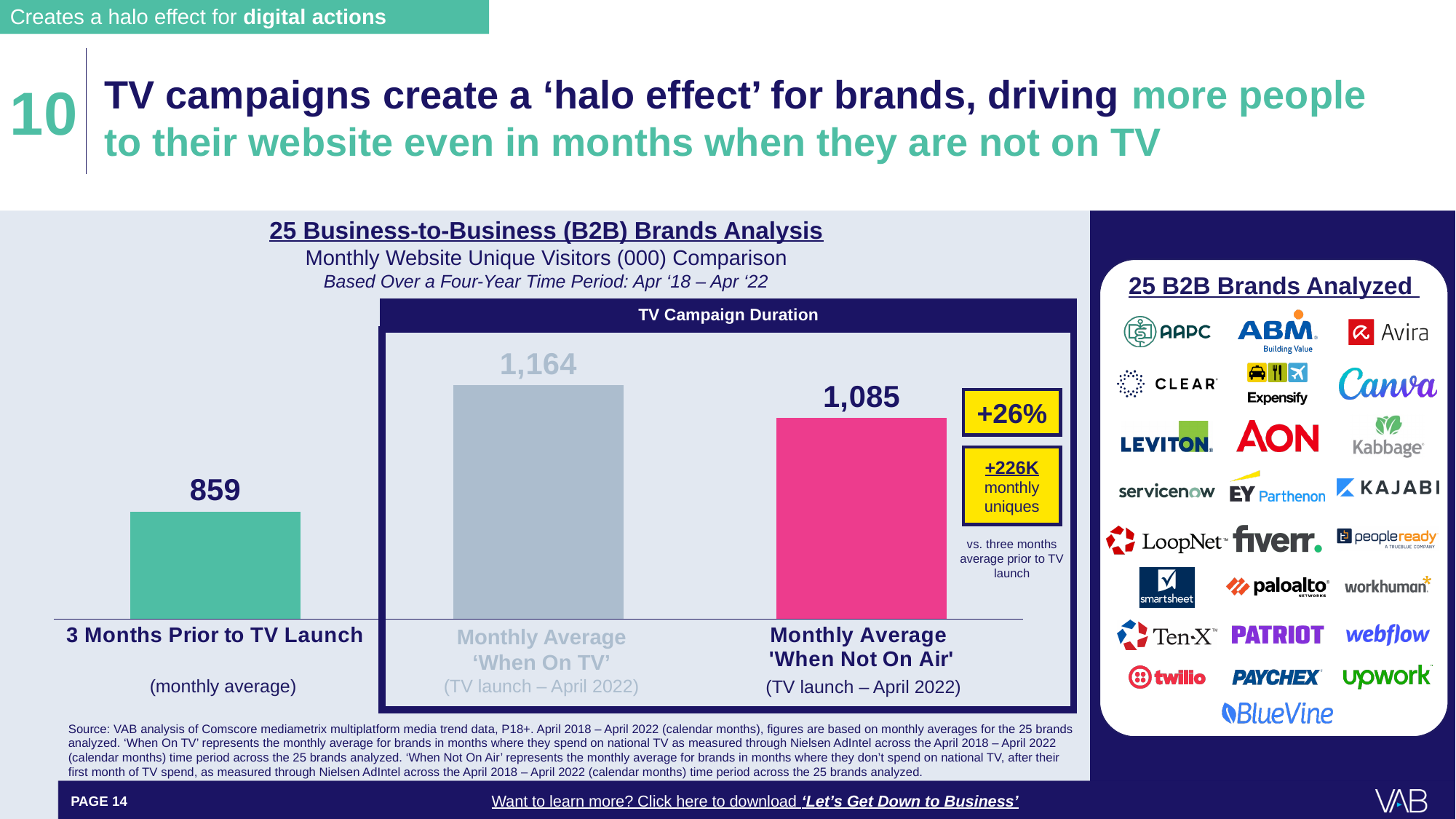
What percentage increase is shown in the callout next to the 'When Not On Air' bar? +26% What is the title of the chart on the slide? 25 Business-to-Business (B2B) Brands Analysis What is the difference between the 'When Not On Air' value and the '3 Months Prior to TV Launch' value? 226 What is the value for the Monthly Average 'When Not On Air' bar? 1,085 Which bar has the highest value in the chart? Monthly Average 'When On TV' What is the difference between the 'When On TV' value and the 'When Not On Air' value? 79 Which bar has the lowest value in the chart? 3 Months Prior to TV Launch Which is larger: the value for 'When Not On Air' or the value for '3 Months Prior to TV Launch'? When Not On Air How many bars are plotted in the chart? 3 What is the value for the Monthly Average 'When On TV' bar? 1,164 What kind of chart is shown on the slide? Bar chart What is the monthly average website unique visitors (000) value for '3 Months Prior to TV Launch'? 859